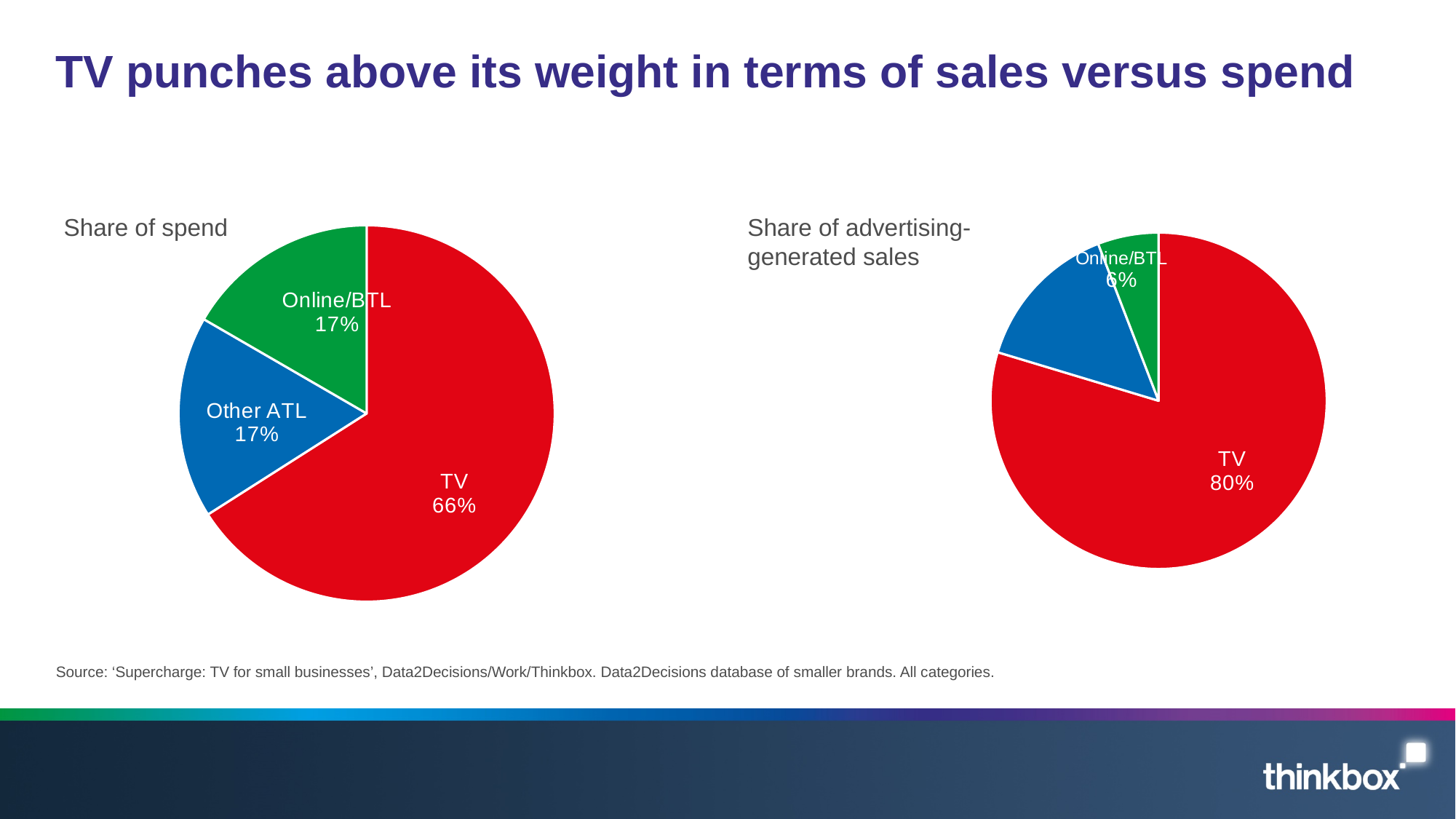
How many slices does the 'Share of spend' pie chart have? 3 In the 'Share of advertising-generated sales' pie chart, what is the share for TV? 80% In the 'Share of advertising-generated sales' pie chart, what is the share for Online/BTL? 6% In the 'Share of advertising-generated sales' pie chart, which category has the largest slice? TV In the 'Share of spend' pie chart, what is the share for Other ATL? 17% In the 'Share of spend' pie chart, what is the difference between the TV share and the Other ATL share? 49 percentage points In the 'Share of spend' pie chart, what is the share for TV? 66% In the 'Share of spend' pie chart, what is the share for Online/BTL? 17% What type of chart is used for 'Share of spend'? Pie chart In the 'Share of advertising-generated sales' pie chart, which is larger, the TV slice or the Online/BTL slice? TV What is the difference between TV's share in the 'Share of advertising-generated sales' chart and TV's share in the 'Share of spend' chart? 14 percentage points In the 'Share of spend' pie chart, which category has the largest slice? TV